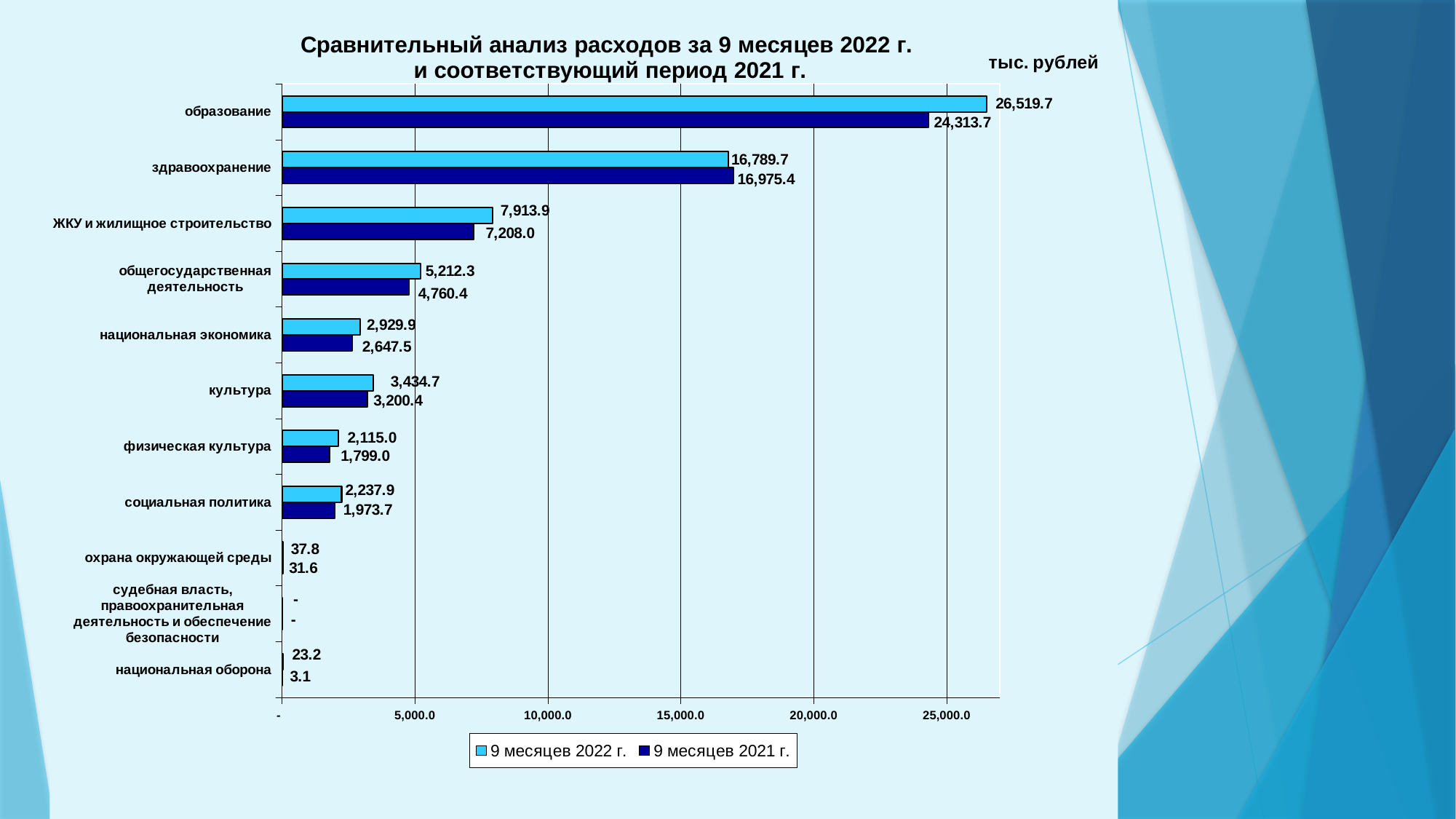
Which category has the highest value in the series 9 месяцев 2022 г.? образование What is the difference between the 9 месяцев 2022 г. and 9 месяцев 2021 г. values for образование? 2,206.0 What is the value for образование in the series 9 месяцев 2022 г.? 26,519.7 Is the value for общегосударственная деятельность in the series 9 месяцев 2022 г. greater or less than 5,000.0? greater How many series does the legend list? 2 For здравоохранение, which series has the larger value: 9 месяцев 2022 г. or 9 месяцев 2021 г.? 9 месяцев 2021 г. Which category has the lowest value in the series 9 месяцев 2021 г. among those with a printed numeric value? национальная оборона What is the value for здравоохранение in the series 9 месяцев 2021 г.? 16,975.4 What type of chart is shown on the slide? bar chart What is the value for национальная оборона in the series 9 месяцев 2021 г.? 3.1 What is the value for ЖКУ и жилищное строительство in the series 9 месяцев 2022 г.? 7,913.9 What unit is indicated in the top right corner of the chart? тыс. рублей